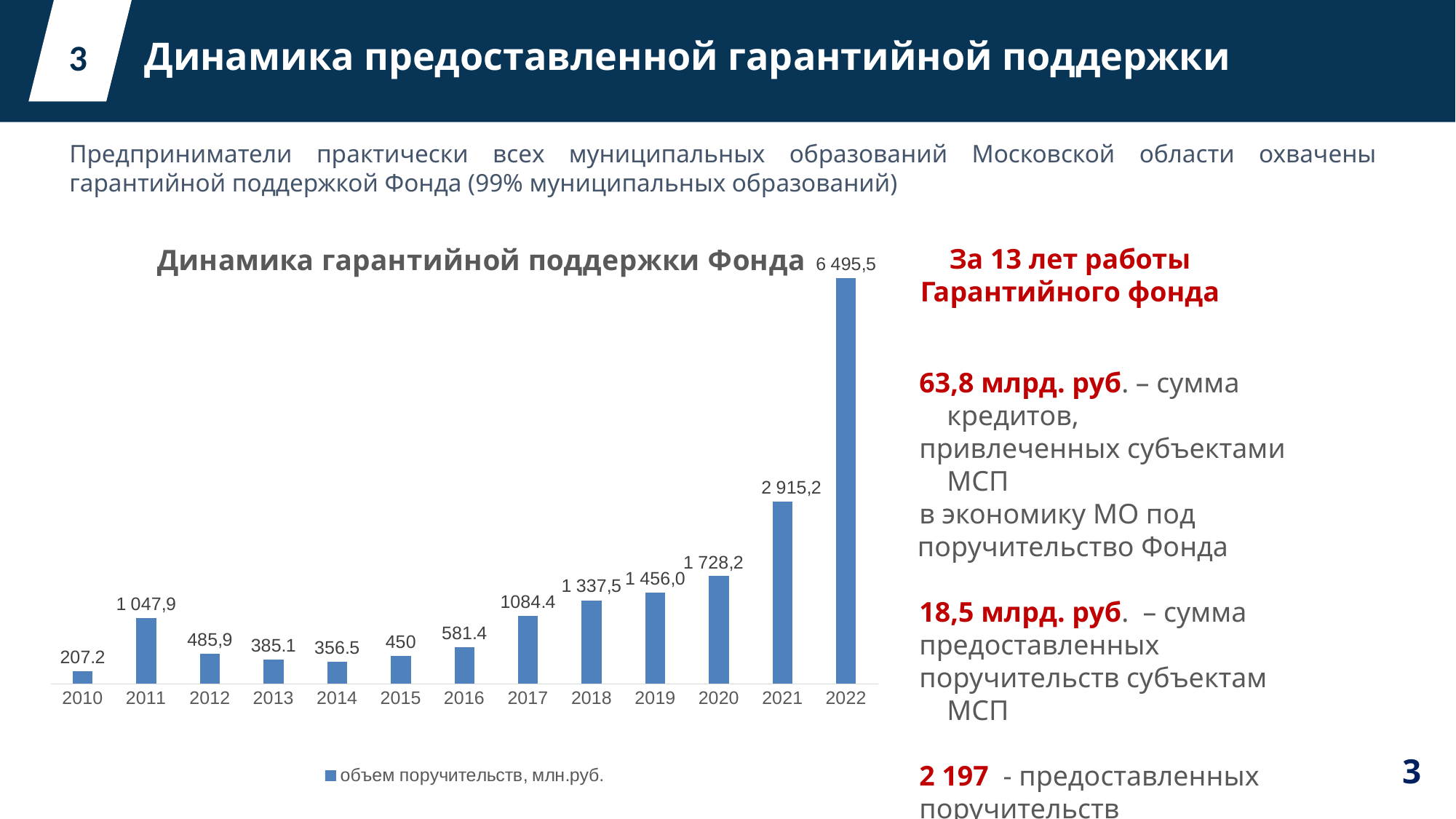
Which is larger, the value for 2011 or the value for 2012? 2011 Which year has the highest value? 2022 What kind of chart is this? bar chart What is the difference between the values for 2022 and 2021? 3 580,3 What is the difference between the values for 2020 and 2019? 272,2 What is the value for 2015? 450 How many years are shown on the x axis? 13 What is the value for 2010? 207.2 What is the value for 2017? 1084.4 What is the legend entry of the chart? объем поручительств, млн.руб. Which year has the lowest value? 2010 What is the value for 2022? 6 495,5